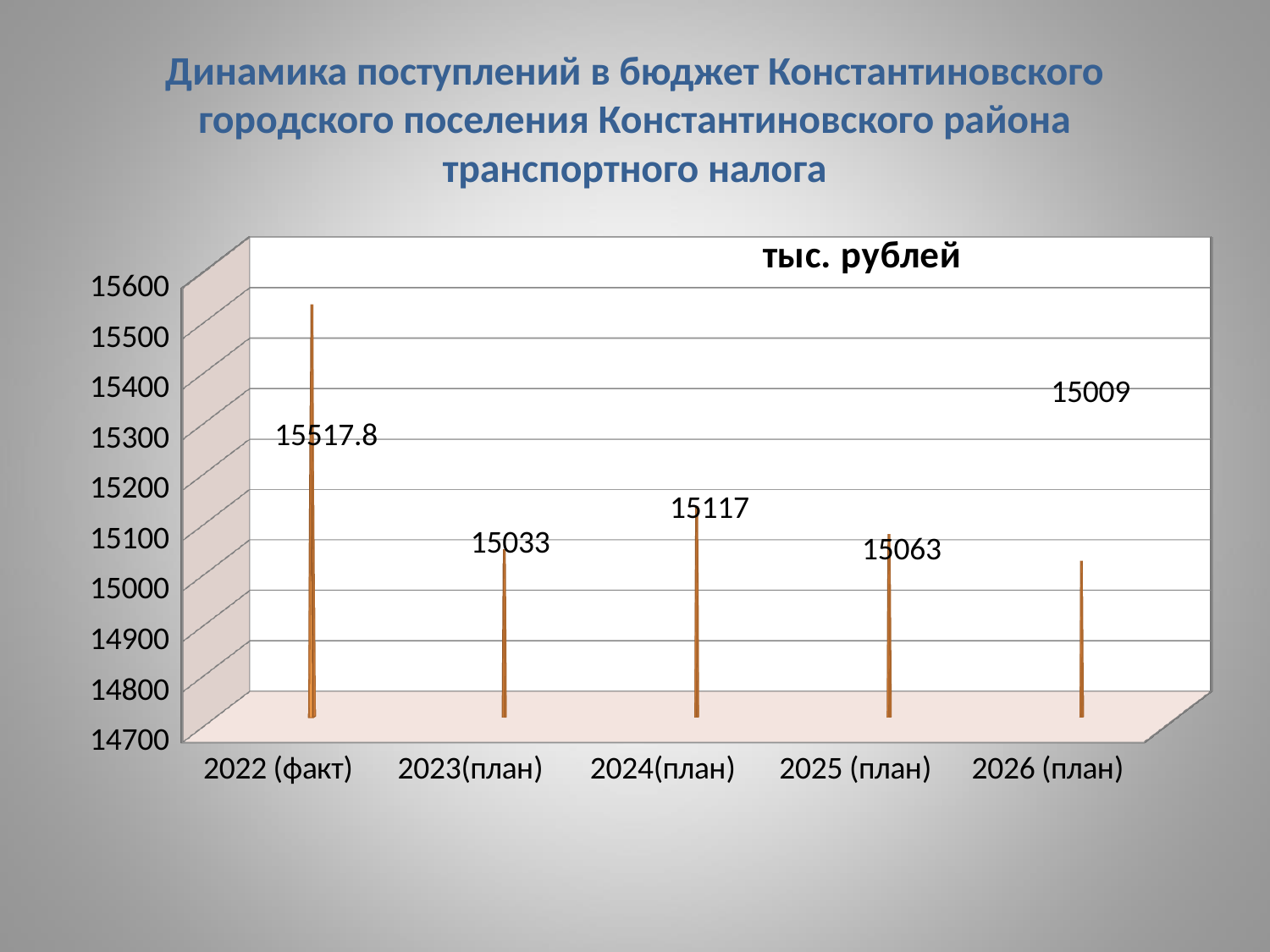
What kind of chart is shown on the slide? bar chart Which is larger, the value for 2025 (план) or the value for 2023(план)? 2025 (план) What unit label is shown inside the chart area? тыс. рублей Which category has the highest value? 2022 (факт) What is the value for 2022 (факт)? 15517.8 Which category has the lowest value? 2026 (план) What is the value for 2026 (план)? 15009 Is the value for 2022 (факт) greater or less than 15500? greater What is the difference between the values for 2022 (факт) and 2026 (план)? 508.8 What is the value for 2024(план)? 15117 What is the difference between the values for 2024(план) and 2023(план)? 84 How many categories are shown on the x axis? 5